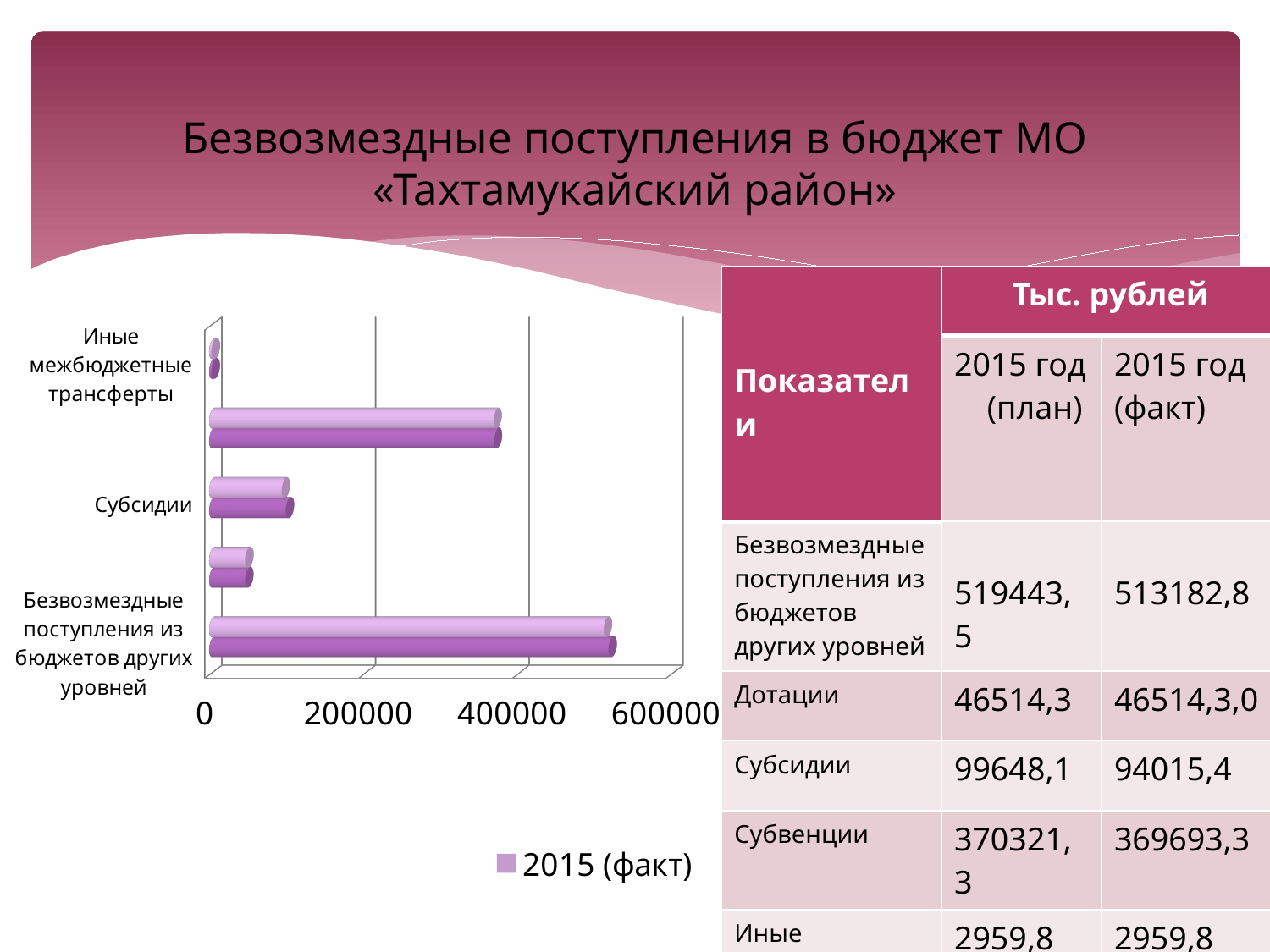
Which is larger in the chart: Субсидии or Иные межбюджетные трансферты? Субсидии What legend entry is shown below the chart? 2015 (факт) Which category has the longest bars in the chart? Безвозмездные поступления из бюджетов других уровней Is the value for Безвозмездные поступления из бюджетов других уровней greater or less than 400000? greater Which category has the shortest bars in the chart? Иные межбюджетные трансферты What kind of chart is shown on the slide? bar chart Is the value for Субсидии greater or less than 200000? less What is the highest tick value shown on the chart's horizontal axis? 600000 How many category groups of bars are plotted in the chart? 5 Which is larger in the chart: Субсидии or Безвозмездные поступления из бюджетов других уровней? Безвозмездные поступления из бюджетов других уровней According to the table on the slide, what is the 2015 (факт) value for Субсидии? 94015,4 Is the value for Иные межбюджетные трансферты greater or less than 200000? less